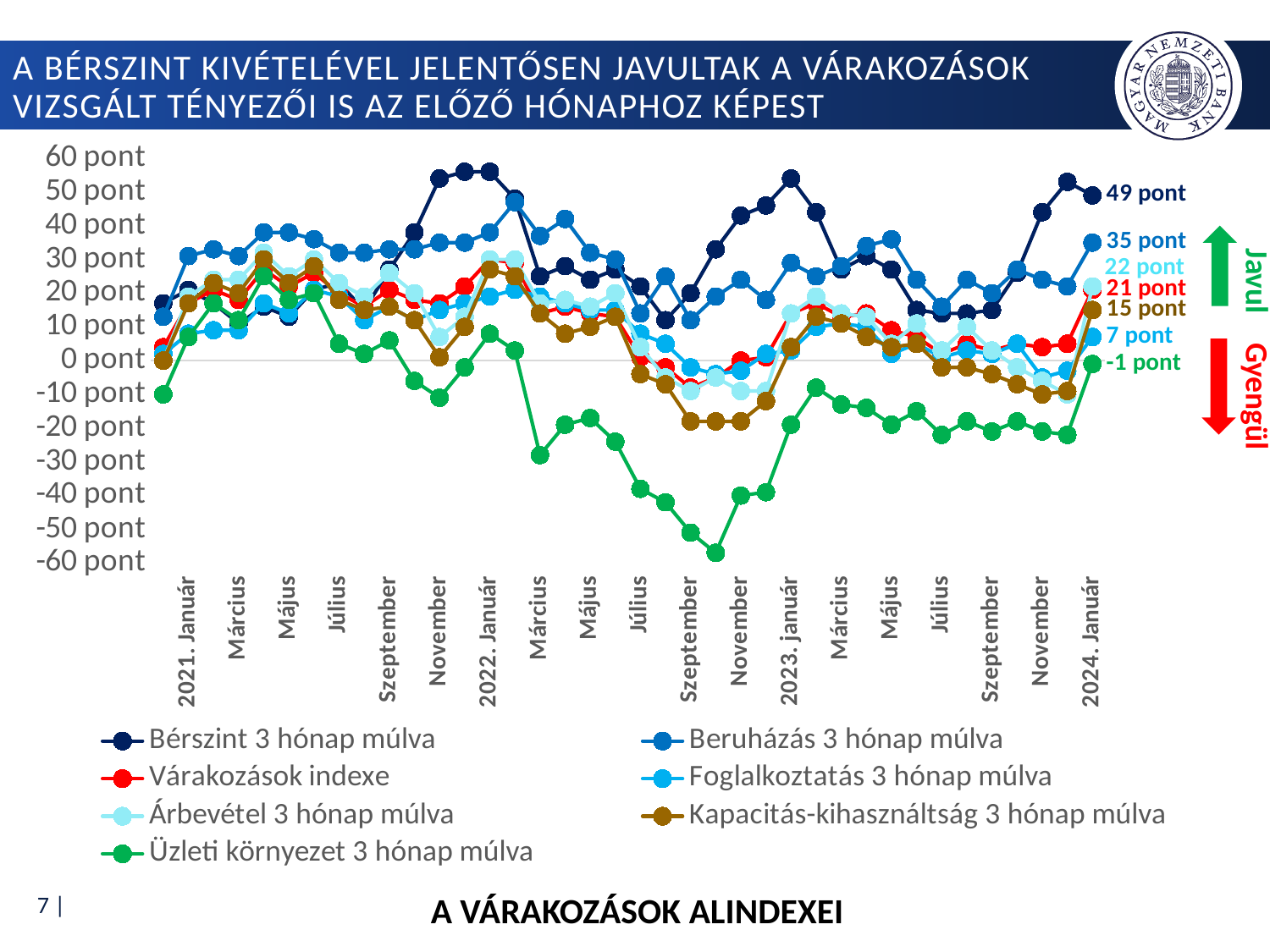
Is the value of 'Üzleti környezet 3 hónap múlva' at 2022. szeptember greater or less than -40 pont? less What is the value of 'Üzleti környezet 3 hónap múlva' at 2024. január? -1 pont What is the value of 'Bérszint 3 hónap múlva' at 2024. január? 49 pont What is the title shown below the chart? A VÁRAKOZÁSOK ALINDEXEI What is the difference between 'Bérszint 3 hónap múlva' and 'Beruházás 3 hónap múlva' at 2024. január? 14 pont What is the value of 'Foglalkoztatás 3 hónap múlva' at 2024. január? 7 pont How many series does the legend list? 7 Which series has the highest value at 2024. január? Bérszint 3 hónap múlva What is the value of 'Várakozások indexe' at 2024. január? 21 pont What is the value of 'Beruházás 3 hónap múlva' at 2024. január? 35 pont Which series has the lowest value at 2024. január? Üzleti környezet 3 hónap múlva What type of chart is shown on the slide? line chart